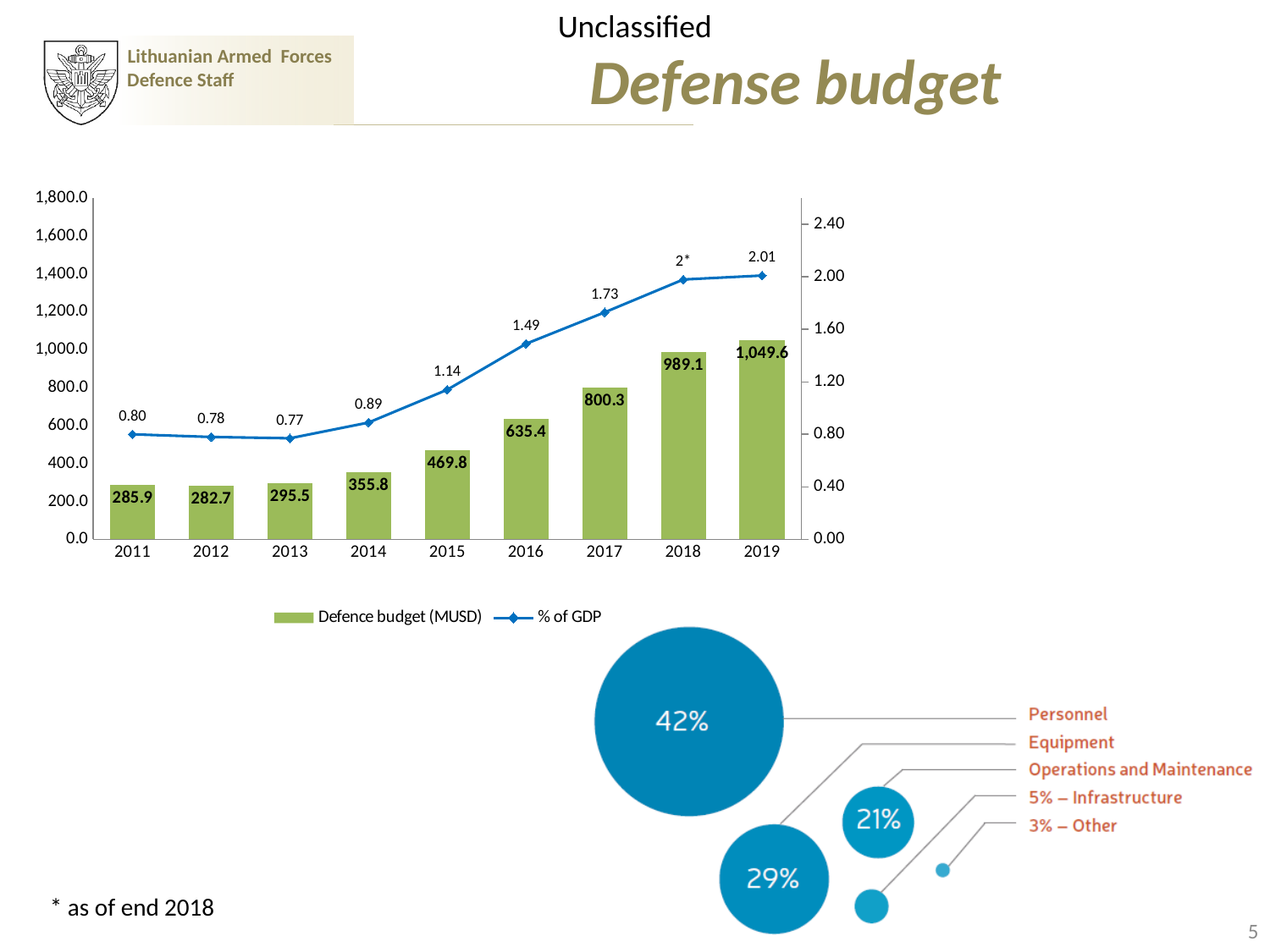
In the top chart, which year has the lowest defence budget (MUSD)? 2012 In the bubble chart at the bottom, what share is labelled for Infrastructure? 5% In the top chart, does the defence budget (MUSD) generally rise or fall from 2013 to 2019? rise In the bubble chart at the bottom, what share is labelled for Personnel? 42% In the top chart, what is the difference between the defence budget (MUSD) for 2018 and 2017? 188.8 In the top chart, how many years are shown on the x axis? 9 In the top chart, which year has the highest % of GDP value? 2019 In the top chart, what does the footnote say the asterisk on the 2018 % of GDP value means? as of end 2018 In the top chart, what is the defence budget (MUSD) for 2019? 1,049.6 In the top chart, which is larger, the defence budget (MUSD) for 2014 or for 2013? 2014 In the top chart, how many series does the legend list? 2 In the top chart, what is the % of GDP value for 2016? 1.49